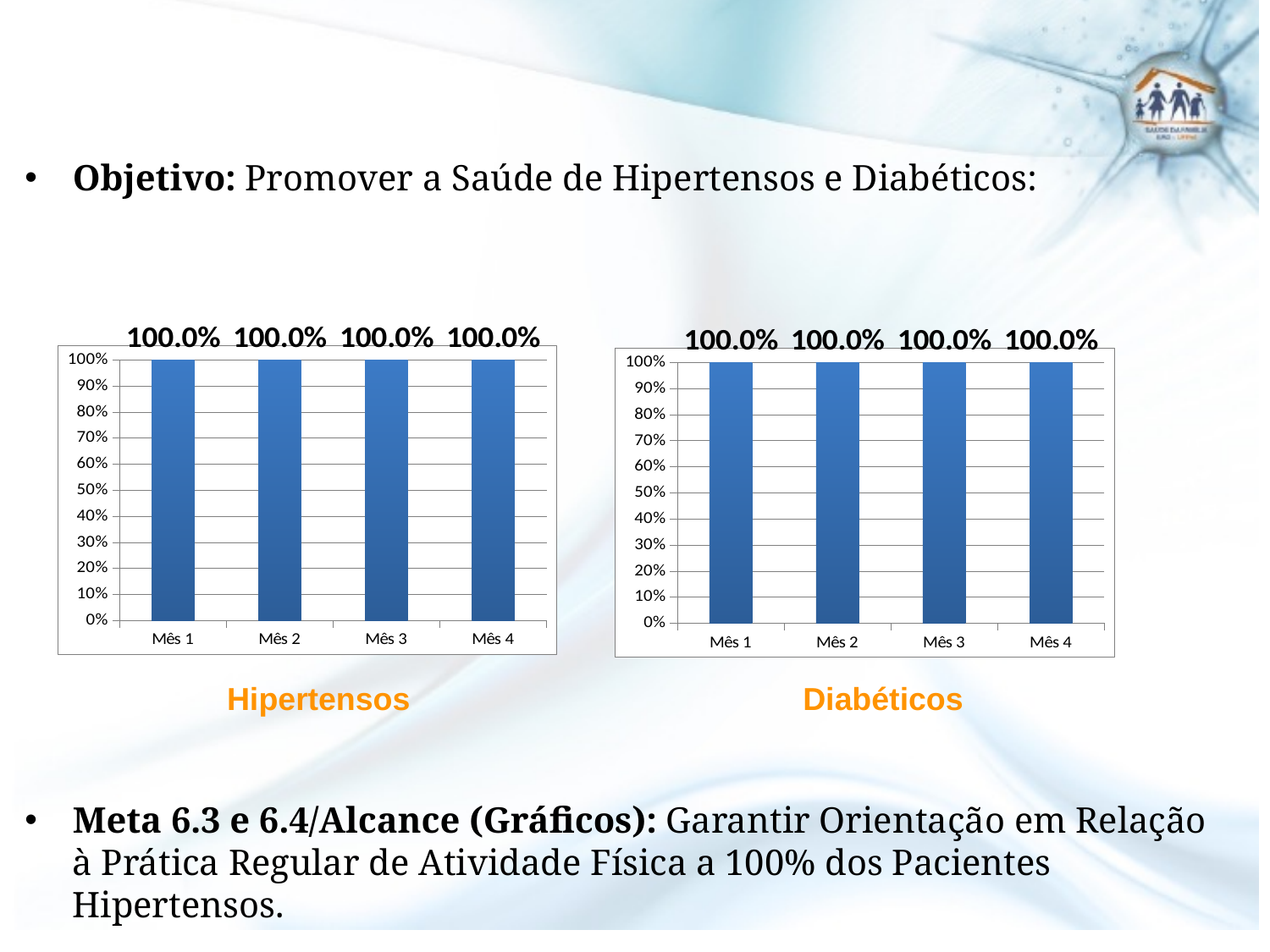
In the Diabéticos chart, what is the difference between the values for Mês 1 and Mês 4? 0.0% In the Diabéticos chart, what is the value for Mês 2? 100.0% In the Diabéticos chart, what is the value for Mês 4? 100.0% What is the label shown beneath the right chart? Diabéticos In the Hipertensos chart, do the values rise, fall or stay the same from Mês 1 to Mês 4? stay the same How many categories are shown on the x axis of the Hipertensos chart? 4 How many bars does the Diabéticos chart have? 4 In the Hipertensos chart, what is the value for Mês 1? 100.0% What is the label shown beneath the left chart? Hipertensos What kind of chart is the Hipertensos chart? bar chart In the Hipertensos chart, what is the value for Mês 3? 100.0% In the Diabéticos chart, is the value for Mês 3 greater or less than 50%? greater